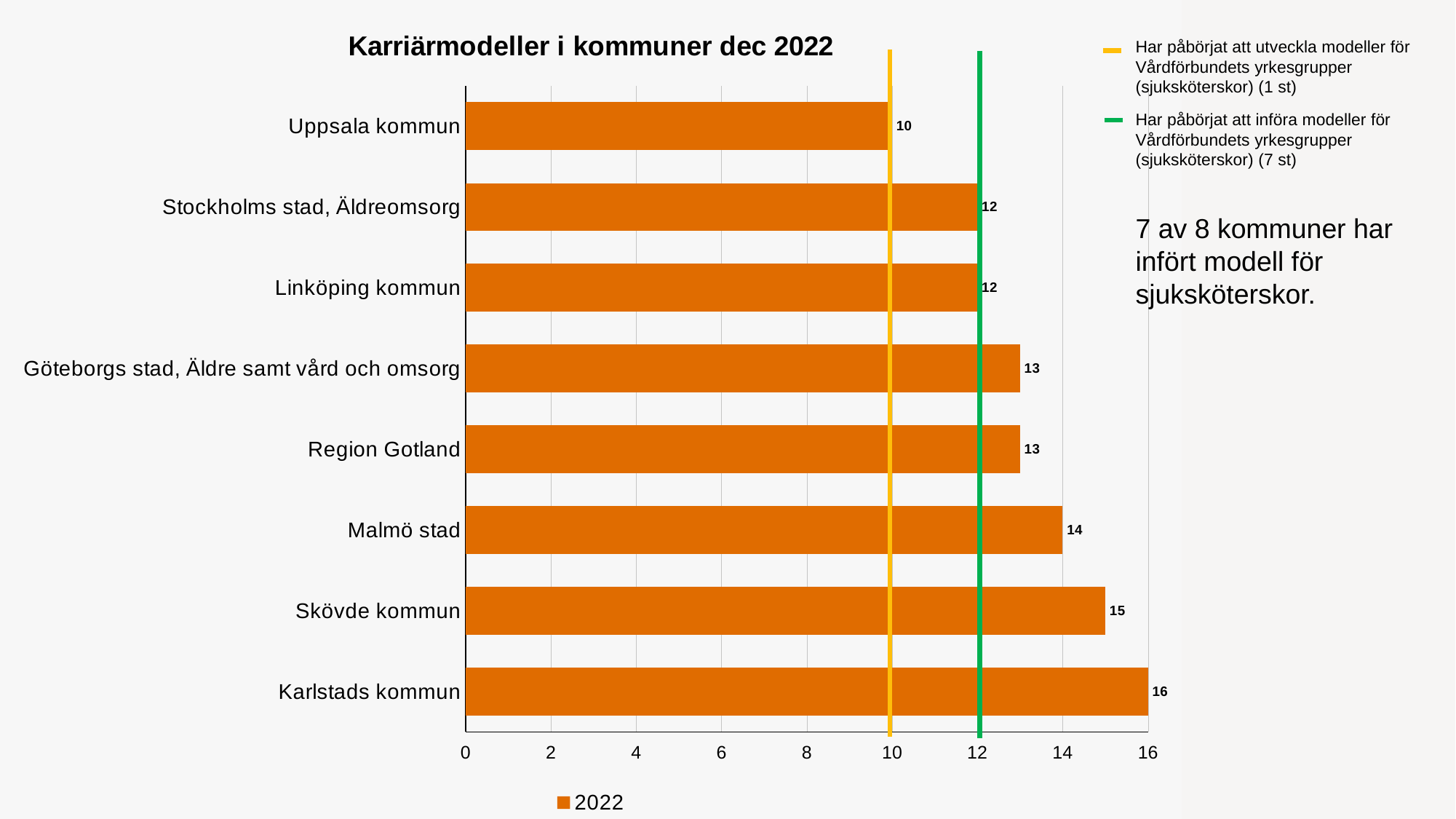
What is the title of the chart? Karriärmodeller i kommuner dec 2022 What is the value for Malmö stad? 14 Which category has the highest value? Karlstads kommun What is the value for Uppsala kommun? 10 What is the difference between the values for Skövde kommun and Linköping kommun? 3 What is the difference between the values for Karlstads kommun and Uppsala kommun? 6 What kind of chart is this? Bar chart What is the value for Karlstads kommun? 16 What is the value for Region Gotland? 13 Which category has the lowest value? Uppsala kommun Which is larger, the value for Malmö stad or the value for Göteborgs stad, Äldre samt vård och omsorg? Malmö stad How many categories are shown in the chart? 8